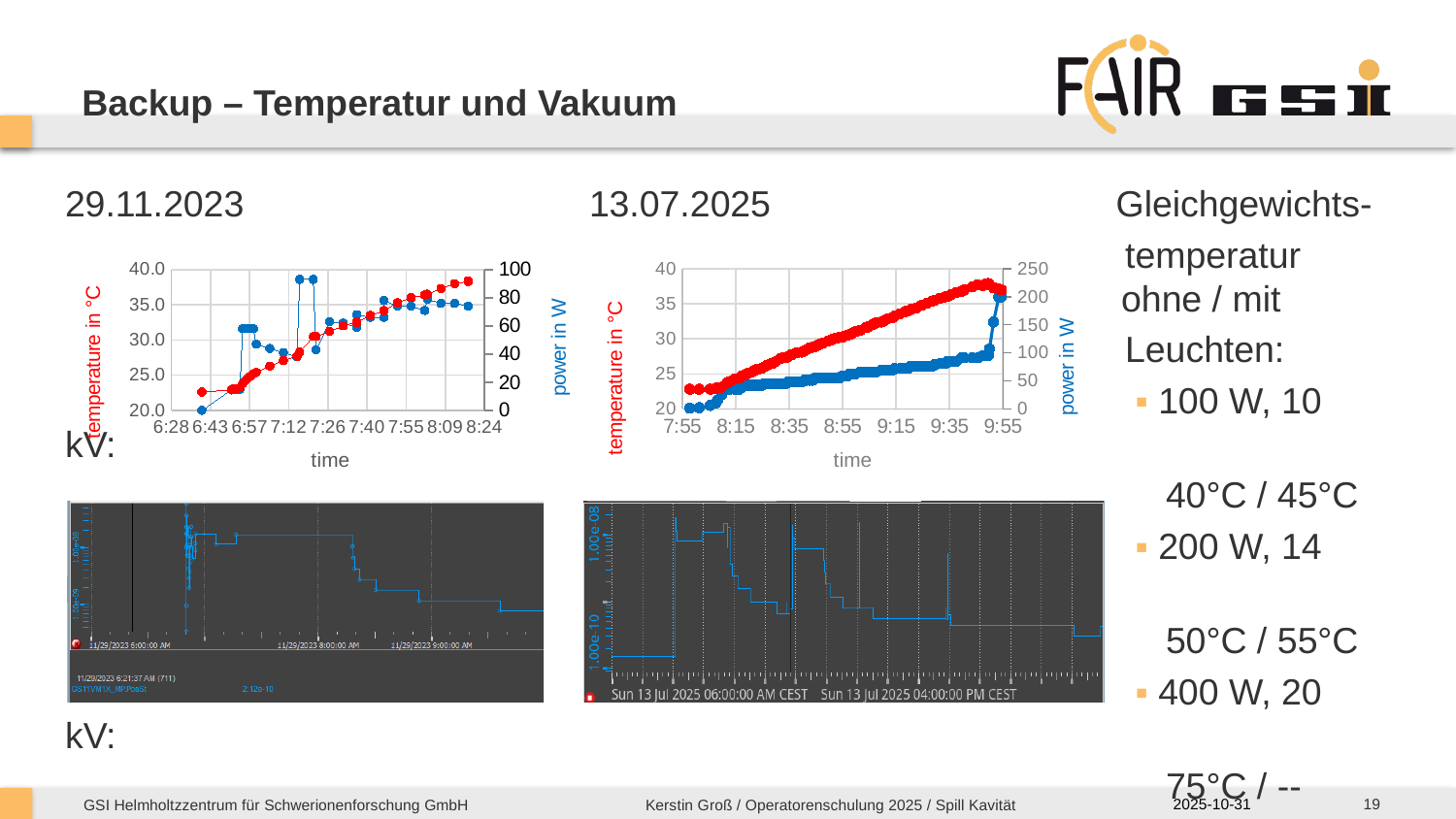
What is the label of the right-hand y-axis of the 29.11.2023 chart? power in W In the 29.11.2023 chart, does the red temperature series rise or fall along the time axis? rise In the 29.11.2023 chart, does the blue power series overall rise or fall from the start to the end of the time axis? rise In the 29.11.2023 chart, is the first red temperature value greater or less than 25? less What kind of chart is the 29.11.2023 chart on the left? line chart In the 13.07.2025 chart, does the red temperature series rise or fall along the time axis? rise In the 29.11.2023 chart, is the last blue power value greater or less than 50? greater What is the x-axis label of the 13.07.2025 chart? time In the 13.07.2025 chart, is the last blue power value greater or less than 150? greater